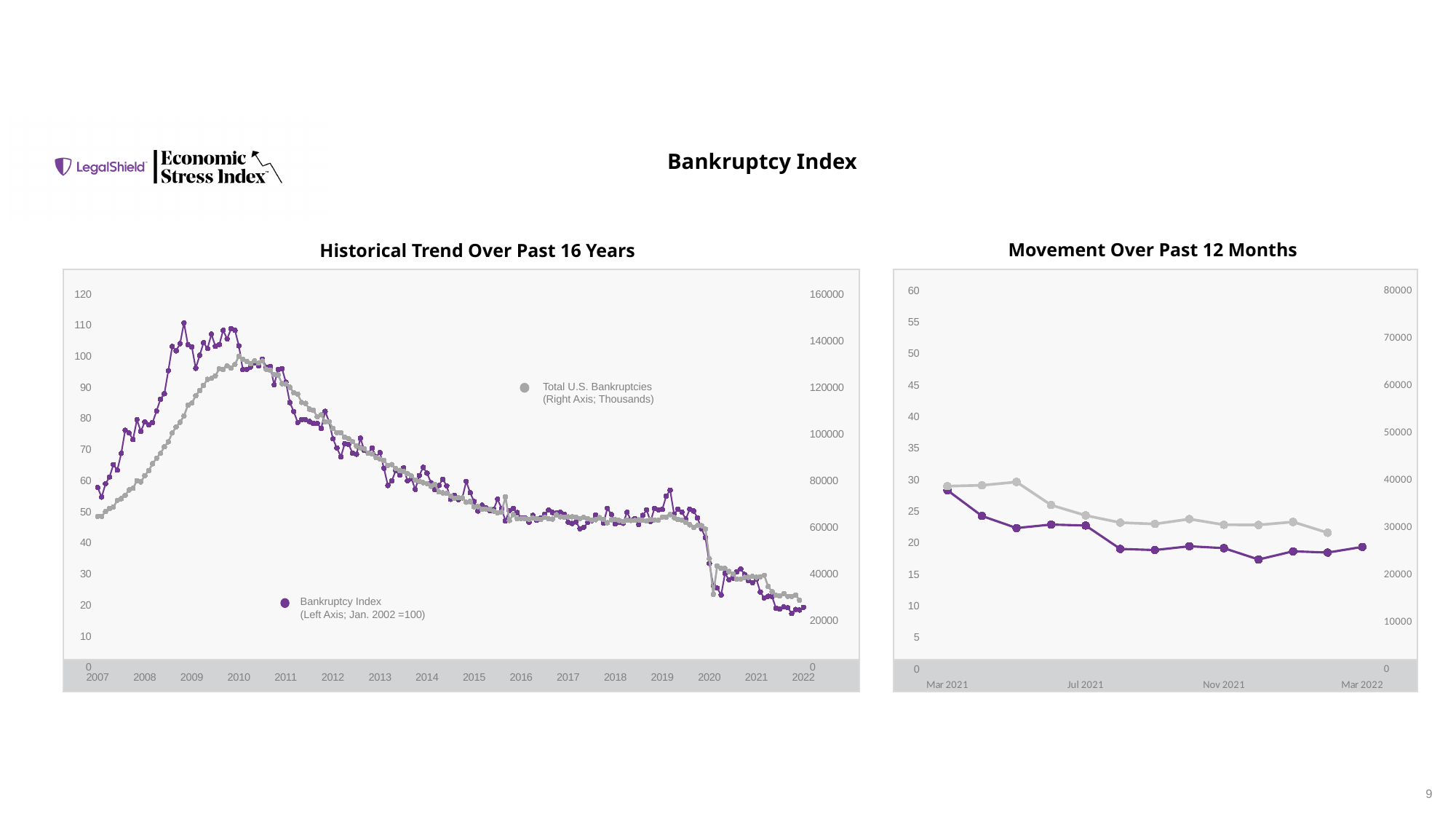
How many series does the legend of the 'Historical Trend Over Past 16 Years' chart list? 2 What kind of chart is the 'Movement Over Past 12 Months' chart? line chart In the 'Movement Over Past 12 Months' chart, is the Bankruptcy Index value for Mar 2022 greater or less than 25? less In the 'Movement Over Past 12 Months' chart, which is larger for the Bankruptcy Index: Mar 2021 or Mar 2022? Mar 2021 In the 'Historical Trend Over Past 16 Years' chart, does the Bankruptcy Index rise or fall from 2010 to 2022? fall In the 'Historical Trend Over Past 16 Years' chart, which axis does the Bankruptcy Index series use? Left axis In the 'Movement Over Past 12 Months' chart, is the Bankruptcy Index value for Mar 2021 greater or less than 25? greater In the 'Historical Trend Over Past 16 Years' chart, what base period is the Bankruptcy Index set to 100? Jan. 2002 In the 'Historical Trend Over Past 16 Years' chart, is the Bankruptcy Index value in 2022 greater or less than 30? less What kind of chart is the 'Historical Trend Over Past 16 Years' chart? line chart In the 'Movement Over Past 12 Months' chart, does the Bankruptcy Index rise or fall from Mar 2021 to Mar 2022? fall